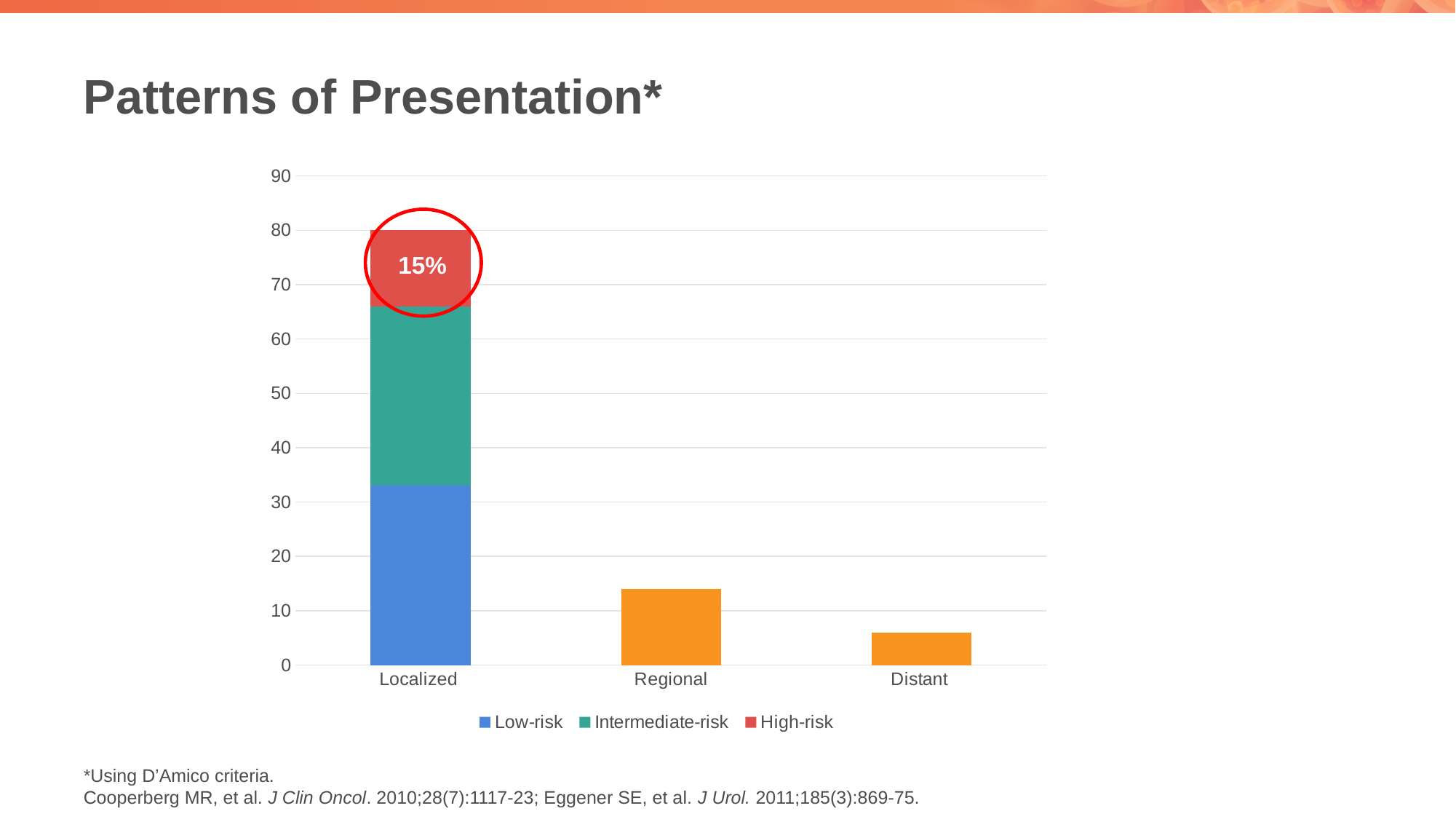
Which bar is taller, Regional or Distant? Regional What is the title of the slide containing the chart? Patterns of Presentation* Which series in the legend is shown in red? High-risk Which category has the shortest bar in the chart? Distant Is the value for Distant greater or less than 10? less Is the value for Regional greater or less than 20? less Is the total height of the Localized bar greater or less than 70? greater What kind of chart is shown on the slide? Stacked bar chart How many series does the chart legend list? 3 Which category has the tallest bar in the chart? Localized How many categories are shown on the x axis of the chart? 3 What value is labelled on the High-risk segment of the Localized bar? 15%